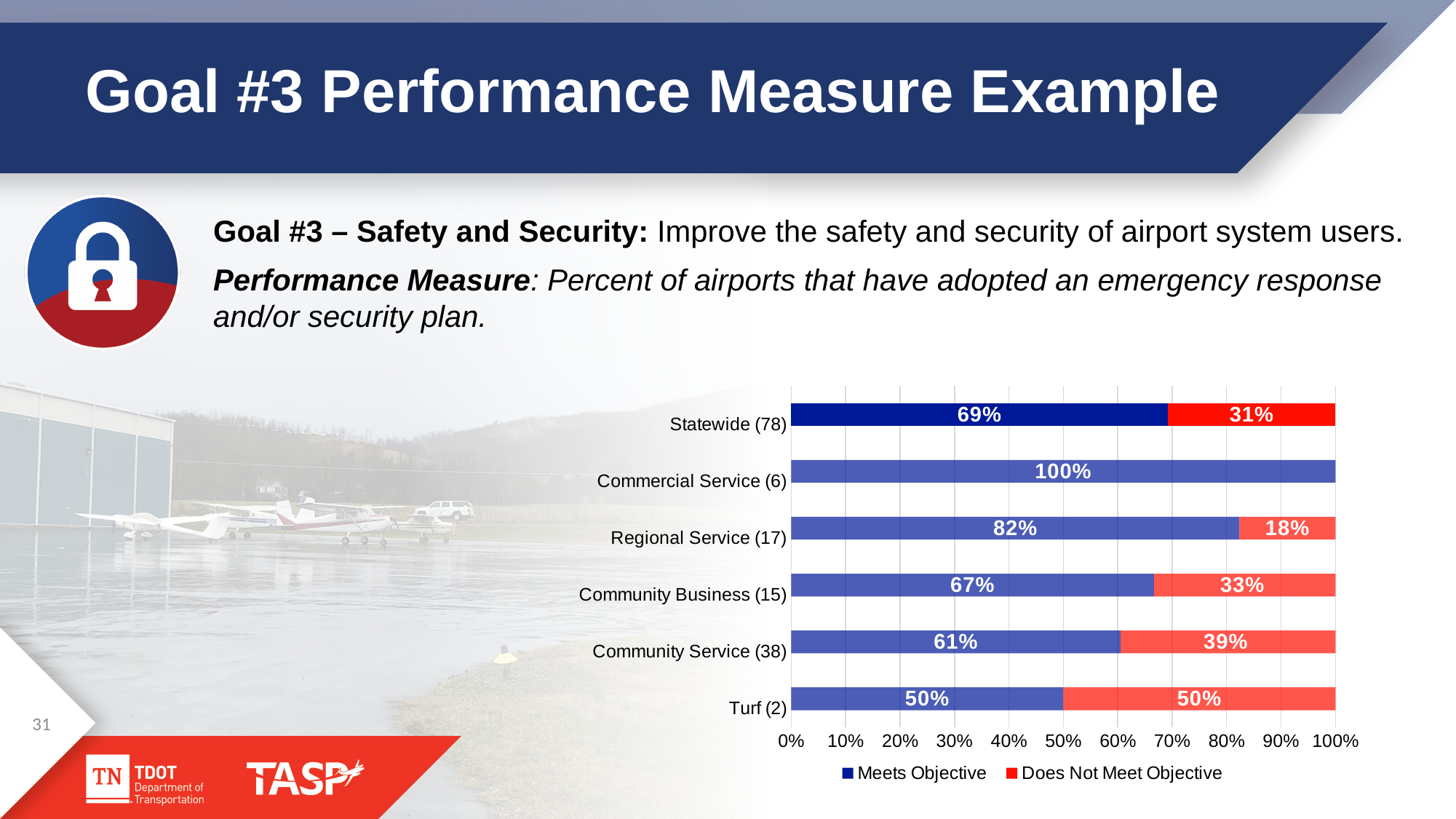
What is the difference between the 'Meets Objective' values for Regional Service (17) and Community Business (15)? 15% What kind of chart is shown on the slide? Stacked bar chart How many categories are shown on the chart? 6 Which category has the highest 'Meets Objective' percentage? Commercial Service (6) What is the 'Does Not Meet Objective' value for Community Service (38)? 39% What percentage of Statewide (78) airports meet the objective? 69% What is the total of the stacked bar for Community Service (38)? 100% What colour represents 'Does Not Meet Objective' in the legend? Red Which category has the lowest 'Meets Objective' percentage? Turf (2) How many series does the legend list? 2 Which is larger: the 'Does Not Meet Objective' value for Community Business (15) or for Statewide (78)? Community Business (15) What is the 'Meets Objective' value for Regional Service (17)? 82%